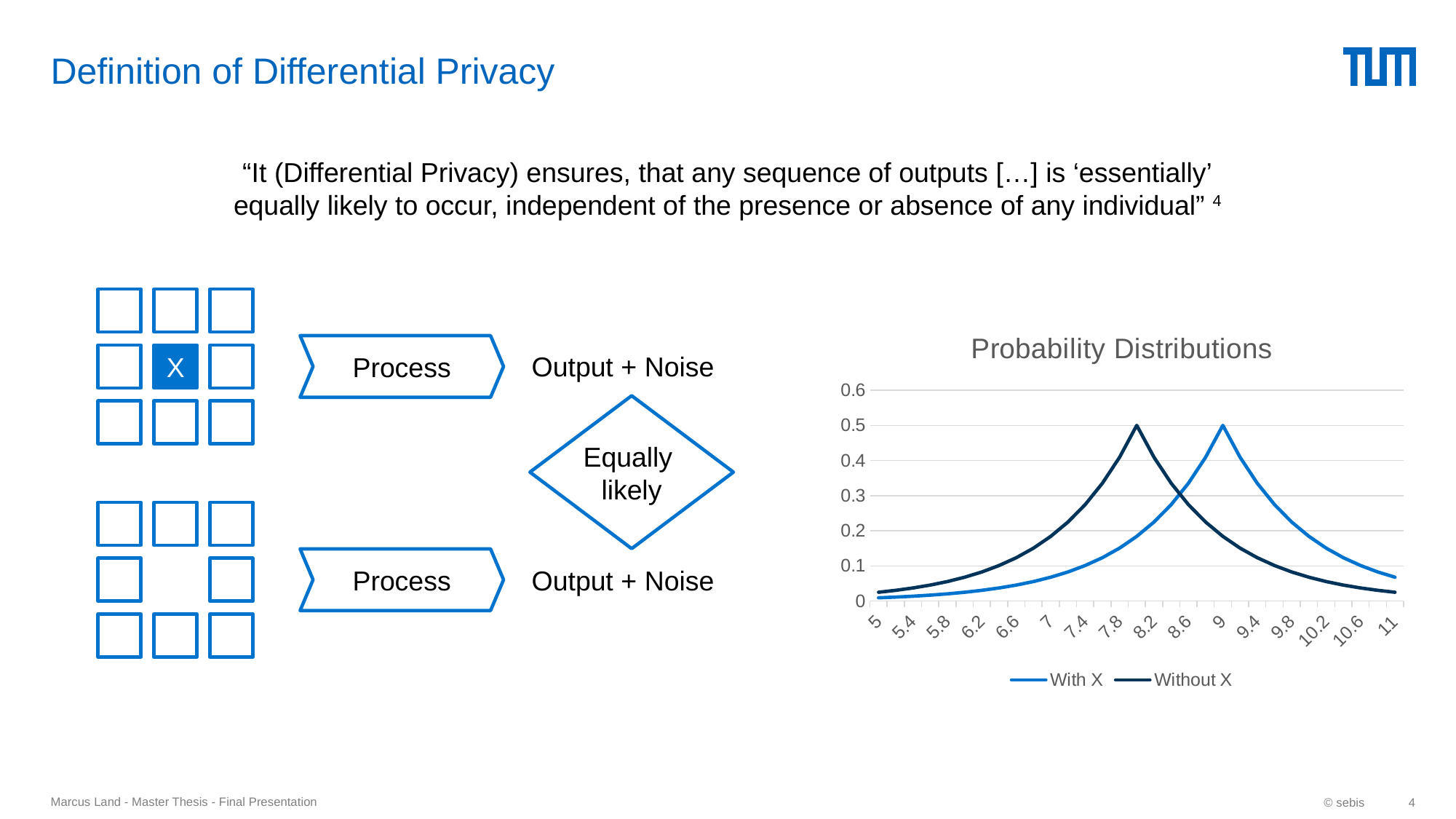
In the "Probability Distributions" chart, does the "With X" line rise or fall as x goes from 5 to 9? rise In the "Probability Distributions" chart, is the value of "With X" at x = 5 greater or less than 0.1? less In the "Probability Distributions" chart, what is the peak value reached by the "With X" series? 0.5 In the "Probability Distributions" chart, does the "Without X" line rise or fall as x goes from 8.2 to 11? fall What is the title of the chart on the right side of the slide? Probability Distributions In the "Probability Distributions" chart, which series has the higher value at x = 10.2, "With X" or "Without X"? With X What kind of chart is shown under the title "Probability Distributions"? line chart What are the two series named in the legend of the "Probability Distributions" chart? With X, Without X In the "Probability Distributions" chart, which series has the higher value at x = 7, "With X" or "Without X"? Without X In the "Probability Distributions" chart, is the value of "With X" at x = 9 greater or less than 0.4? greater How many series does the legend of the "Probability Distributions" chart list? 2 In the "Probability Distributions" chart, is the value of "Without X" at x = 11 greater or less than 0.1? less